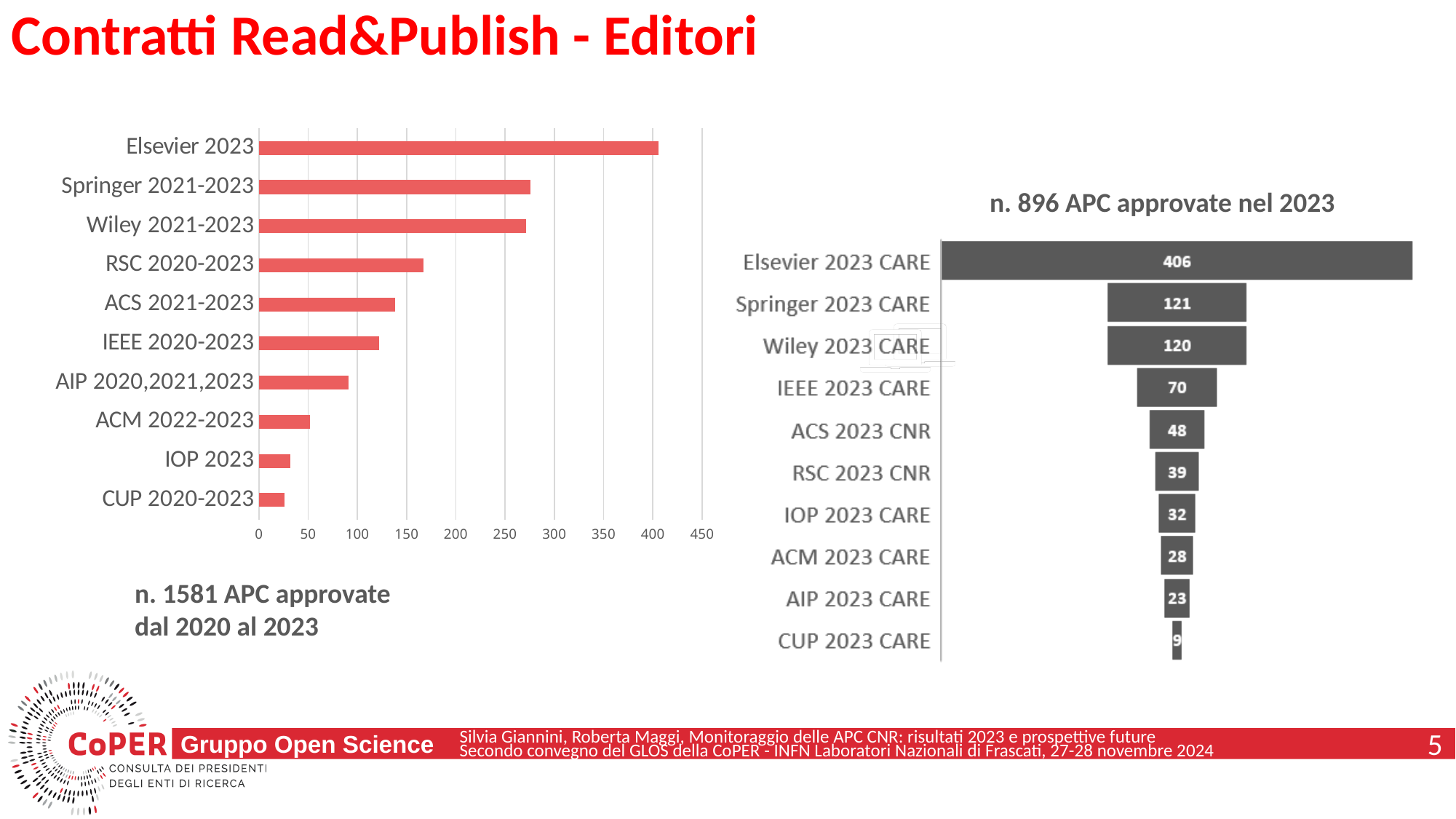
In the left chart (n. 1581 APC approvate dal 2020 al 2023), is the value for ACM 2022-2023 greater or less than 100? less In the right chart titled 'n. 896 APC approvate nel 2023', what is the value for Elsevier 2023 CARE? 406 In the right chart titled 'n. 896 APC approvate nel 2023', what is the difference between ACS 2023 CNR and RSC 2023 CNR? 9 In the right chart titled 'n. 896 APC approvate nel 2023', which category has the lowest value? CUP 2023 CARE In the right chart titled 'n. 896 APC approvate nel 2023', what is the value for IEEE 2023 CARE? 70 In the right chart titled 'n. 896 APC approvate nel 2023', what is the value for CUP 2023 CARE? 9 What kind of chart is the left chart (n. 1581 APC approvate dal 2020 al 2023)? bar chart In the left chart (n. 1581 APC approvate dal 2020 al 2023), which category has the highest value? Elsevier 2023 In the left chart (n. 1581 APC approvate dal 2020 al 2023), is the value for RSC 2020-2023 greater or less than 150? greater In the right chart titled 'n. 896 APC approvate nel 2023', how many categories are shown? 10 In the left chart (n. 1581 APC approvate dal 2020 al 2023), which is larger: ACS 2021-2023 or AIP 2020,2021,2023? ACS 2021-2023 In the right chart titled 'n. 896 APC approvate nel 2023', what is the difference between Elsevier 2023 CARE and Springer 2023 CARE? 285